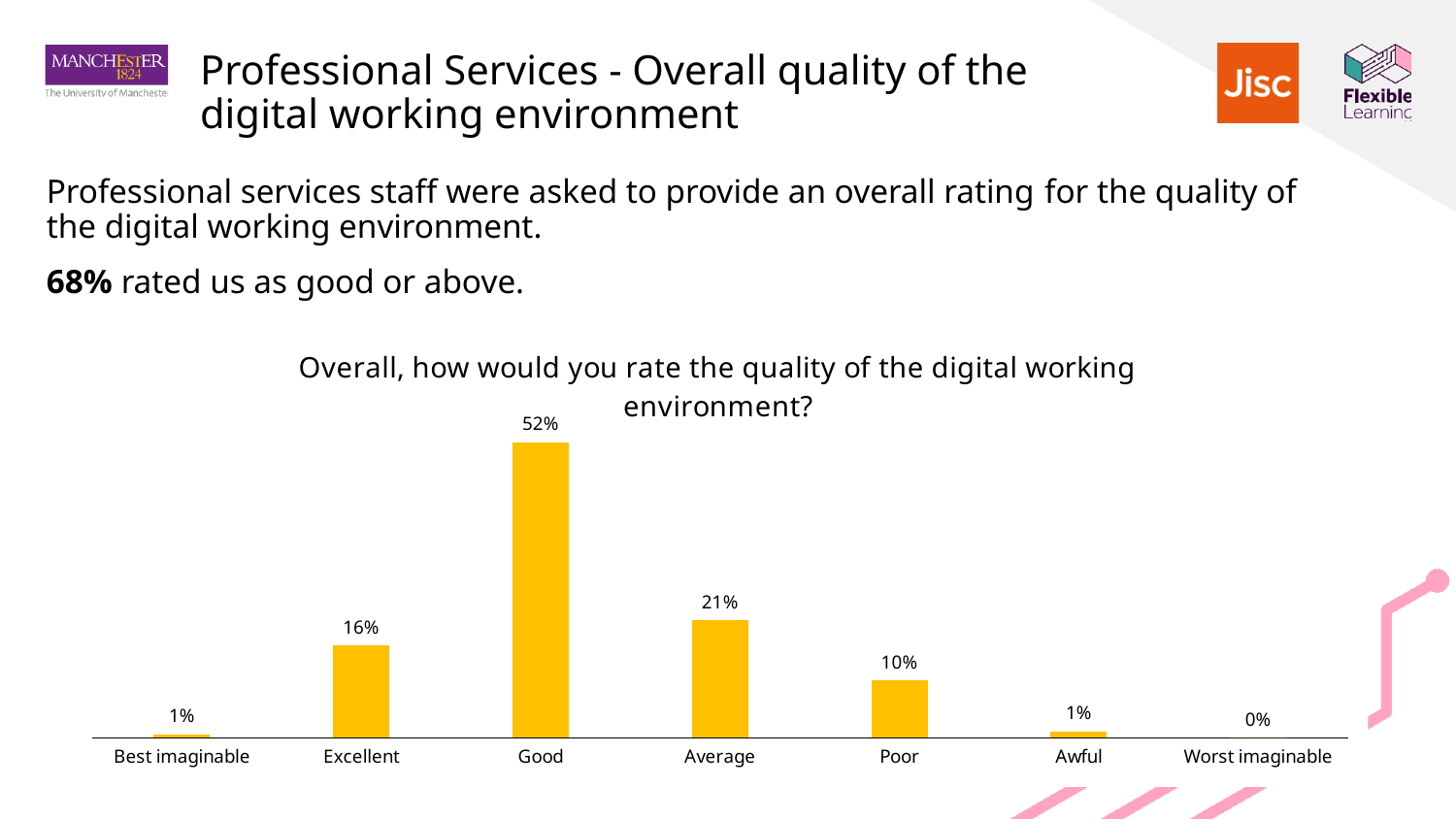
What is the difference in percentage points between Excellent and Poor? 6 What percentage of professional services staff rated the digital working environment as Good? 52% What percentage rated the digital working environment as Worst imaginable? 0% What percentage rated the digital working environment as Poor? 10% What is the title of the chart? Overall, how would you rate the quality of the digital working environment? Which rating category has the lowest percentage? Worst imaginable What percentage rated the digital working environment as Average? 21% Which rating category has the highest percentage? Good What type of chart is shown on the slide? Bar chart Which is larger, the percentage for Excellent or the percentage for Average? Average What is the difference in percentage points between Good and Average? 31 How many rating categories are shown on the x axis? 7